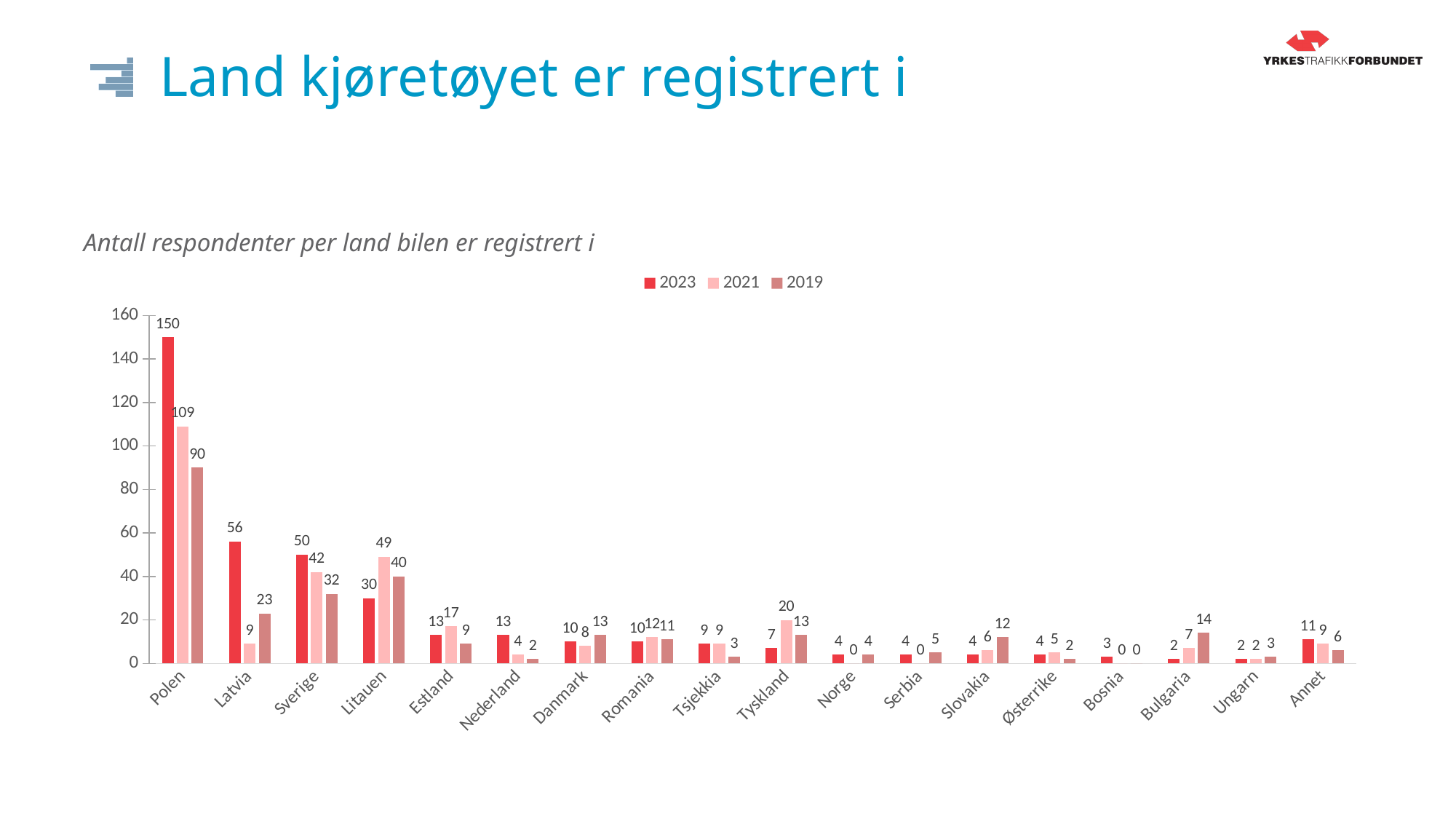
Which category has the lowest 2019 value? Bosnia For Tyskland, which is larger: the 2021 value or the 2023 value? 2021 How many countries/categories are shown on the x axis? 18 What is the 2019 value for Bulgaria? 14 What kind of chart is shown on the slide? Bar chart How many series does the legend list? 3 Is the 2021 value for Polen greater or less than 100? greater What is the difference between the 2023 and 2021 values for Latvia? 47 Which country has the highest 2023 value? Polen What is the title of the chart? Antall respondenter per land bilen er registrert i What is the 2021 value for Litauen? 49 What is the 2023 value for Polen? 150